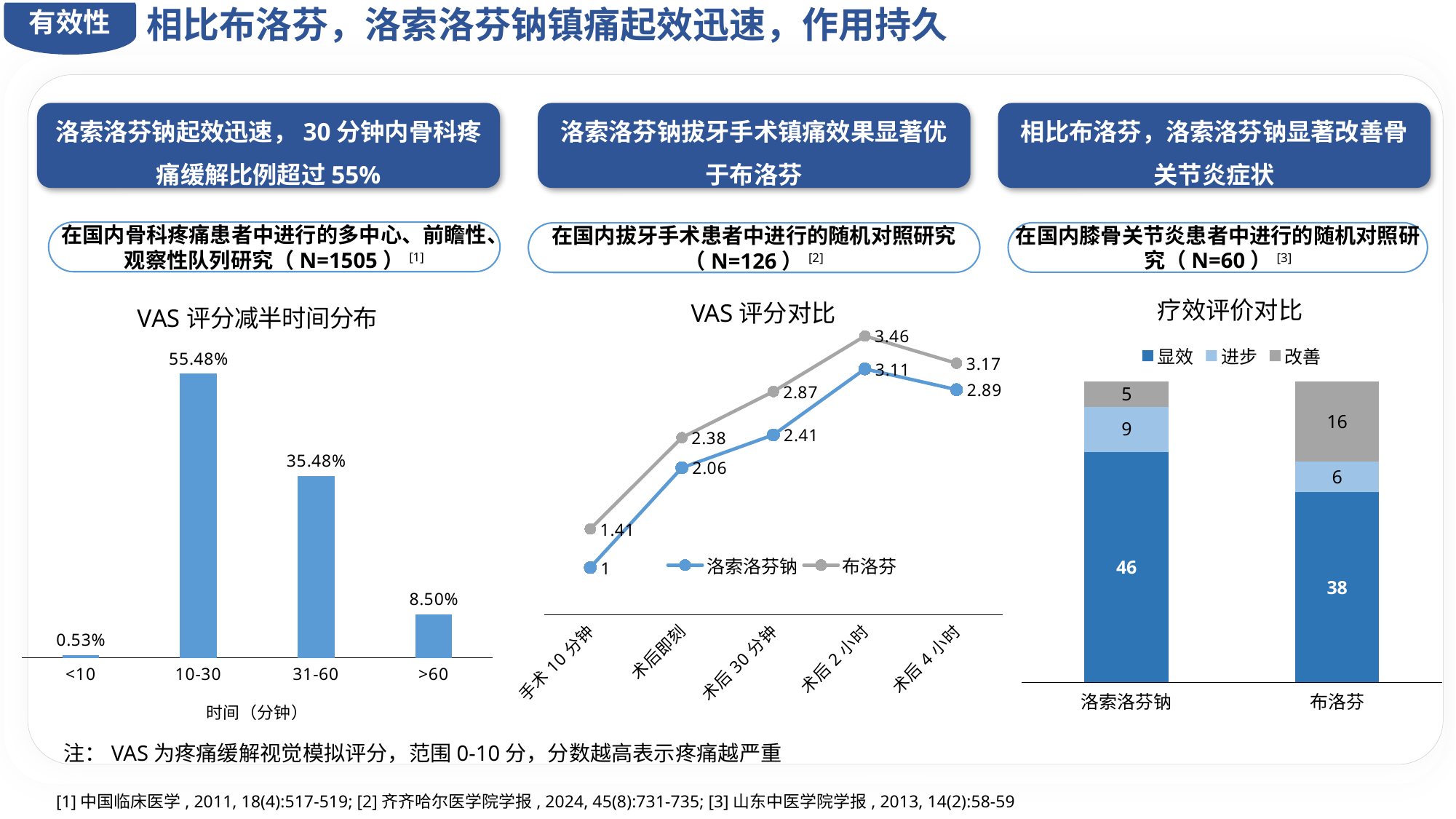
In the chart titled "VAS 评分对比", which series has the higher value at 术后 4 小时, 洛索洛芬钠 or 布洛芬? 布洛芬 In the chart titled "疗效评价对比", what is the total of the stacked bar for 洛索洛芬钠? 60 In the chart titled "VAS 评分对比", what is the value for 洛索洛芬钠 at 术后即刻? 2.06 In the chart titled "VAS 评分对比", what kind of chart is it? Line chart In the chart titled "疗效评价对比", what is the difference between the 改善 values for 布洛芬 and 洛索洛芬钠? 11 In the chart titled "VAS 评分减半时间分布", which category has the lowest value? <10 In the chart titled "VAS 评分减半时间分布", how many categories are shown on the x axis? 4 In the chart titled "VAS 评分对比", what is the value for 布洛芬 at 术后 2 小时? 3.46 In the chart titled "疗效评价对比", what is the 显效 value for 布洛芬? 38 In the chart titled "VAS 评分减半时间分布", what is the difference between the 10-30 and 31-60 values? 20.00% In the chart titled "VAS 评分减半时间分布", what is the value for the 10-30 category? 55.48% In the chart titled "VAS 评分对比", how many series does the legend list? 2